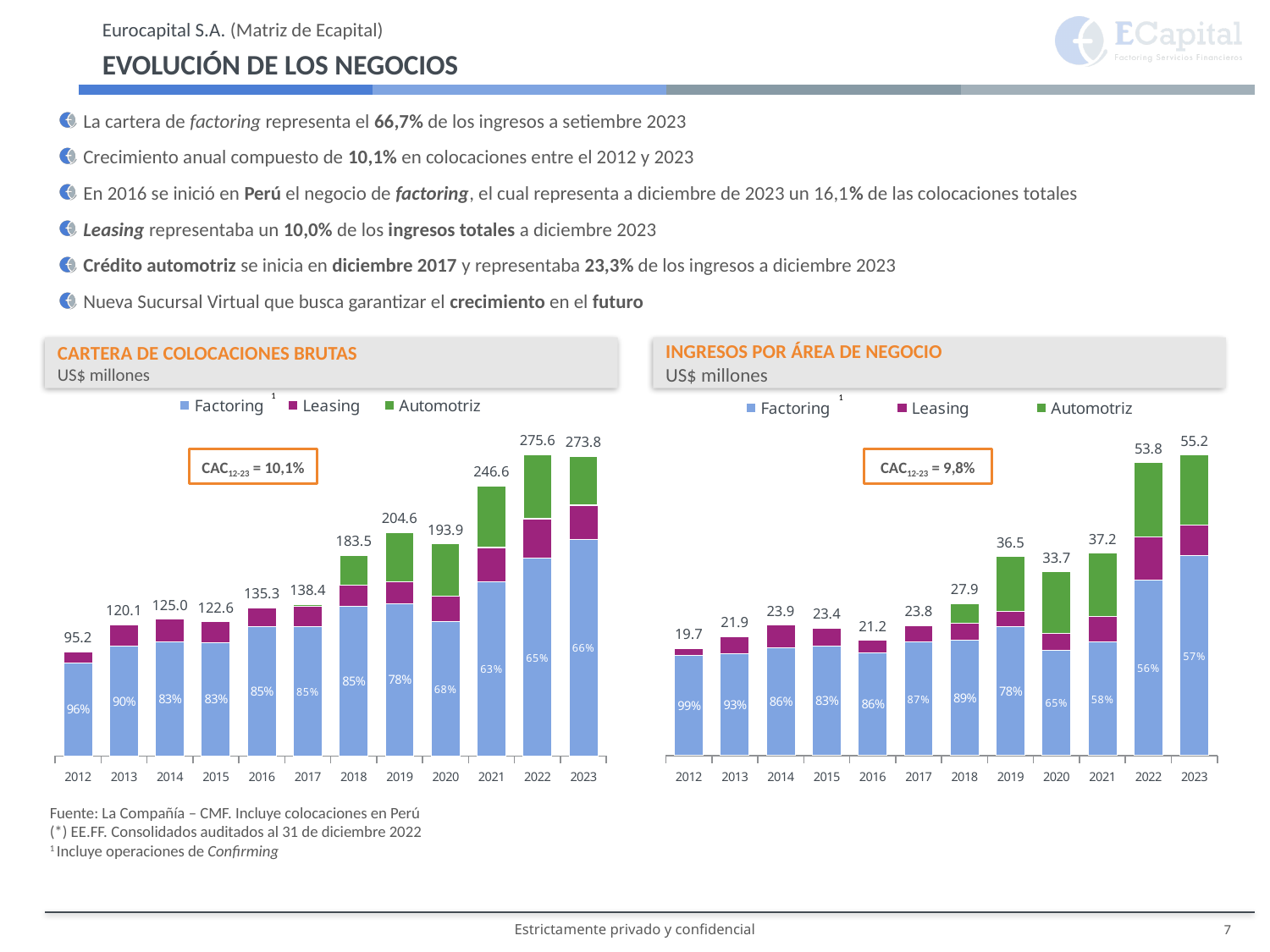
In the CARTERA DE COLOCACIONES BRUTAS chart, how many series does the legend list? 3 In the CARTERA DE COLOCACIONES BRUTAS chart, which year has the lowest total? 2012 In the CARTERA DE COLOCACIONES BRUTAS chart, what percentage share does Factoring have in 2020? 68% In the INGRESOS POR ÁREA DE NEGOCIO chart, how many years are shown on the x axis? 12 In the CARTERA DE COLOCACIONES BRUTAS chart, what is the difference between the totals for 2023 and 2012? 178.6 In the INGRESOS POR ÁREA DE NEGOCIO chart, what is the total value for 2023? 55.2 In the CARTERA DE COLOCACIONES BRUTAS chart, what CAC value is shown in the box? CAC12-23 = 10,1% In the INGRESOS POR ÁREA DE NEGOCIO chart, what is the difference between the totals for 2022 and 2021? 16.6 In the CARTERA DE COLOCACIONES BRUTAS chart, what is the total value for 2022? 275.6 In the INGRESOS POR ÁREA DE NEGOCIO chart, which total is larger, 2019 or 2020? 2019 In the INGRESOS POR ÁREA DE NEGOCIO chart, which year has the highest total? 2023 What kind of chart is the INGRESOS POR ÁREA DE NEGOCIO chart? Stacked bar chart